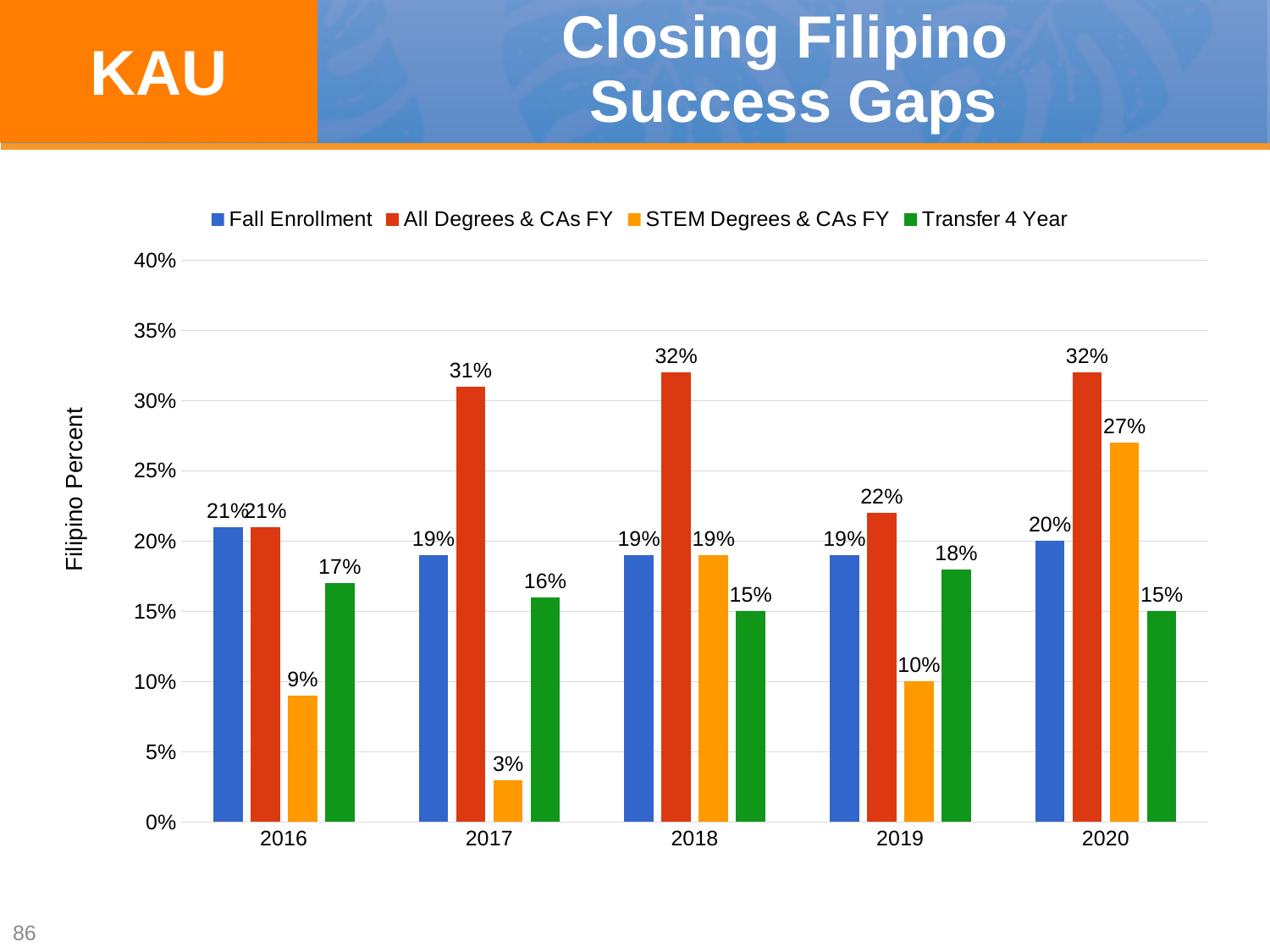
What kind of chart is shown on the slide? Bar chart Which is larger in 2019: All Degrees & CAs FY or Transfer 4 Year? All Degrees & CAs FY What is the label of the y axis? Filipino Percent What is the value for STEM Degrees & CAs FY in 2017? 3% In which year is the STEM Degrees & CAs FY value lowest? 2017 What is the value for Fall Enrollment in 2020? 20% In which year is the STEM Degrees & CAs FY value highest? 2020 What is the value for Transfer 4 Year in 2019? 18% What is the value for All Degrees & CAs FY in 2018? 32% How many series does the legend list? 4 What is the difference between All Degrees & CAs FY and Fall Enrollment in 2017? 12% How many years are shown on the x axis? 5